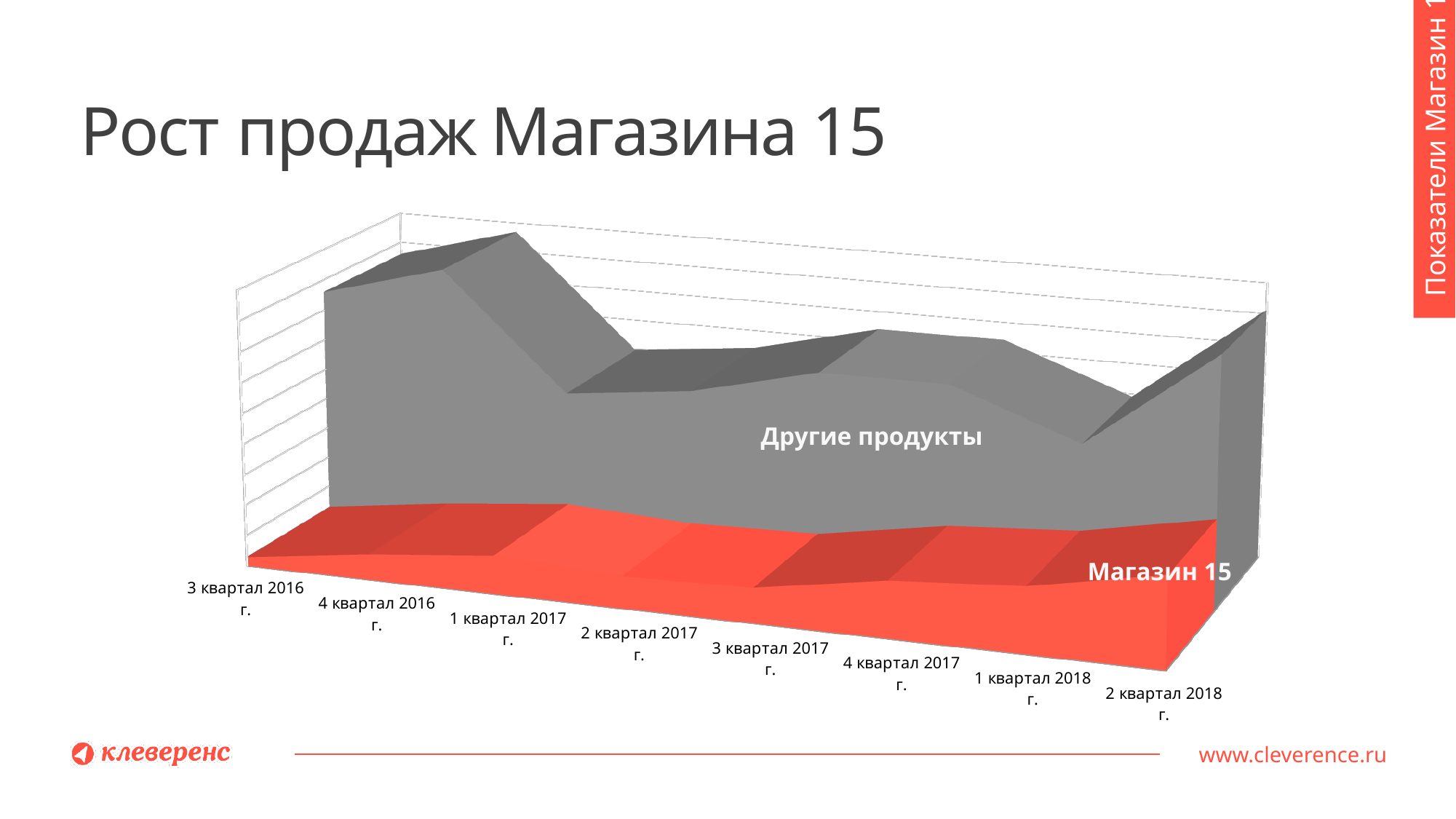
What is the title of the slide's chart? Рост продаж Магазина 15 How many quarters are plotted along the x axis? 8 In which quarter does the Другие продукты series reach its highest point? 4 квартал 2016 г. What is the first quarter shown on the x axis? 3 квартал 2016 г. How many series does the chart show? 2 For the Другие продукты series, is the value for 1 квартал 2017 г. larger or smaller than the value for 2 квартал 2017 г.? smaller Which series is drawn in red? Магазин 15 Does the Магазин 15 series rise or fall from 3 квартал 2016 г. to 2 квартал 2018 г.? rise In which quarter does the Другие продукты series reach its lowest point? 1 квартал 2018 г. What is the last quarter shown on the x axis? 2 квартал 2018 г. What kind of chart is shown on the slide? area chart